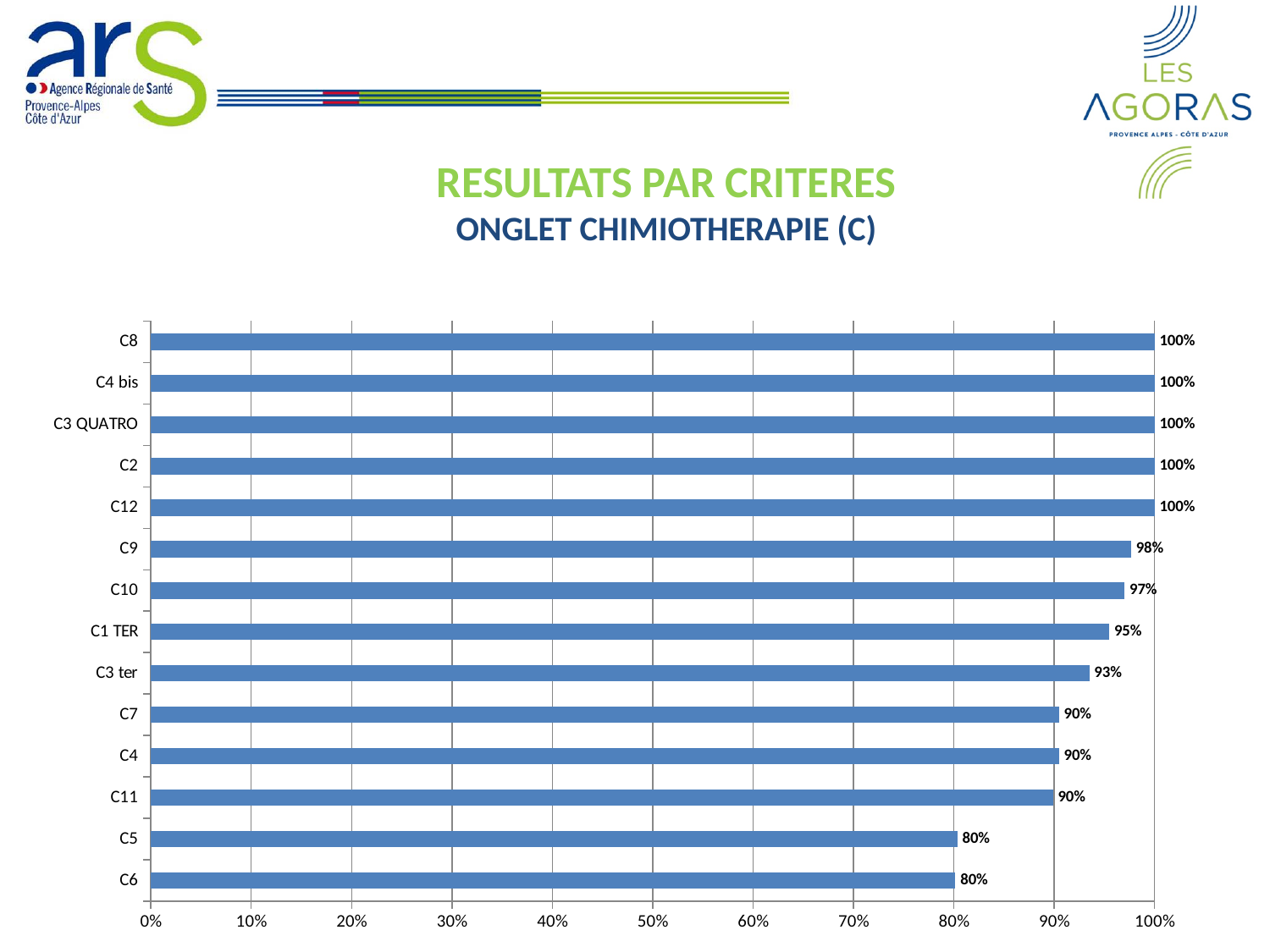
What is the subtitle shown above the chart? ONGLET CHIMIOTHERAPIE (C) What is the difference between the values for C9 and C5? 18% What is the value for C9? 98% Which is larger, the value for C1 TER or the value for C7? C1 TER What is the difference between the values for C10 and C3 ter? 4% What is the value for C1 TER? 95% What kind of chart is shown on the slide? bar chart How many categories are shown on the chart? 14 What is the value for C3 ter? 93% What is the value for C10? 97% What is the value for C6? 80% Is the value for C5 greater or less than 90%? less